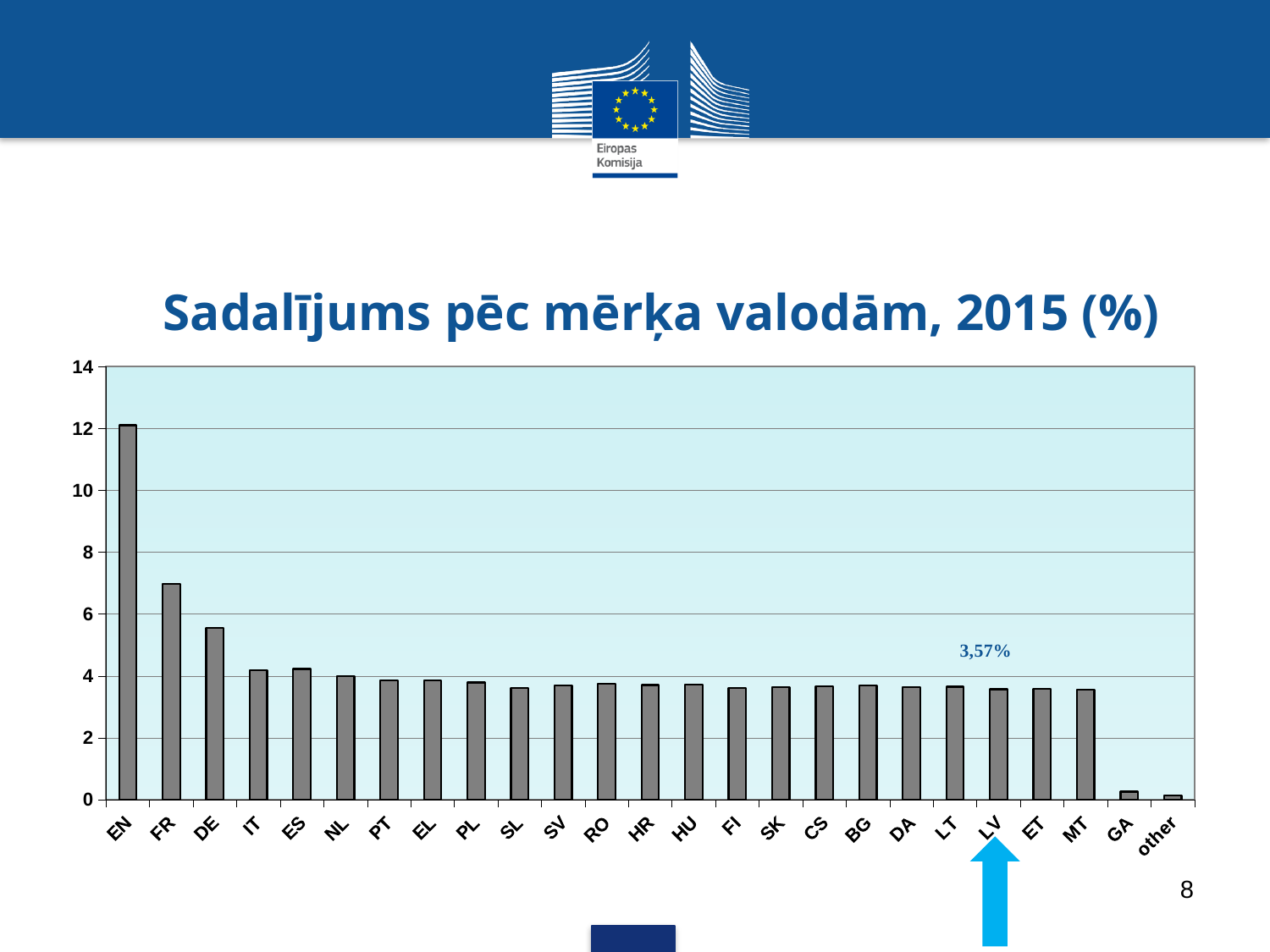
Which category has the lowest value in the chart? other What is the title of the chart? Sadalījums pēc mērķa valodām, 2015 (%) Do the values generally rise or fall moving from left to right along the x axis? fall How many categories are shown on the x axis of the chart? 25 What value is labelled for LV in the chart? 3,57% Is the value for DE greater or less than 6? less Which category has the highest value in the chart? EN Is the value for GA greater or less than 2? less What kind of chart is shown on the slide? bar chart Is the value for EN greater or less than 10? greater Which has the larger value, FR or DE? FR